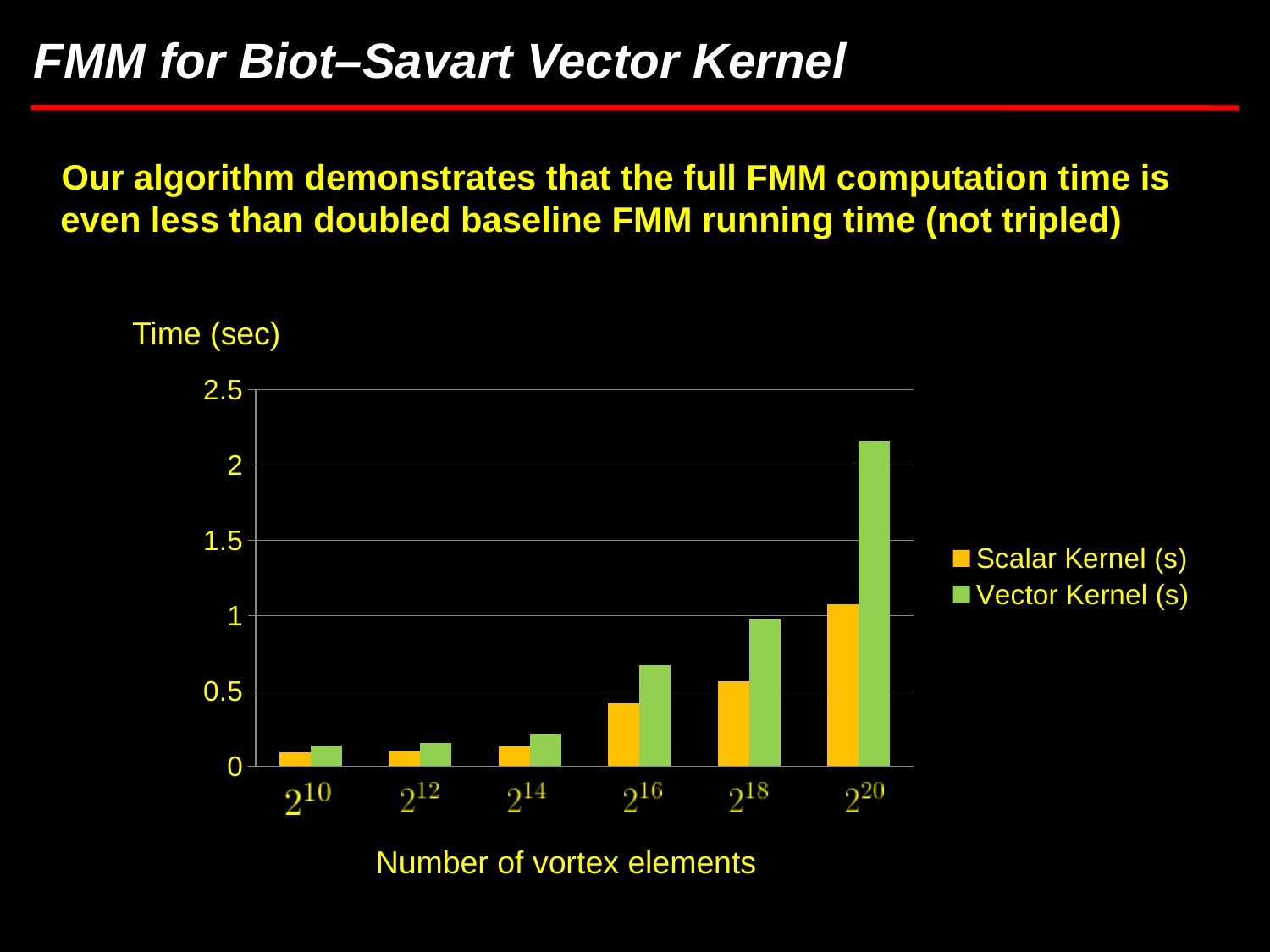
For which number of vortex elements is the Vector Kernel (s) time highest? 2^20 For which number of vortex elements is the Scalar Kernel (s) time highest? 2^20 Is the Vector Kernel (s) value at 2^16 greater or less than 0.5? greater Is the Scalar Kernel (s) value at 2^16 greater or less than 0.5? less What is the x-axis label of the chart? Number of vortex elements What kind of chart is shown on the slide? bar chart Which series is shown in green? Vector Kernel (s) How many categories are shown on the x axis? 6 Is the Vector Kernel (s) value at 2^20 greater or less than 2? greater Do the Vector Kernel (s) times rise or fall as the number of vortex elements increases? rise At 2^20, which is larger: the Scalar Kernel (s) time or the Vector Kernel (s) time? Vector Kernel (s) How many series does the legend list? 2